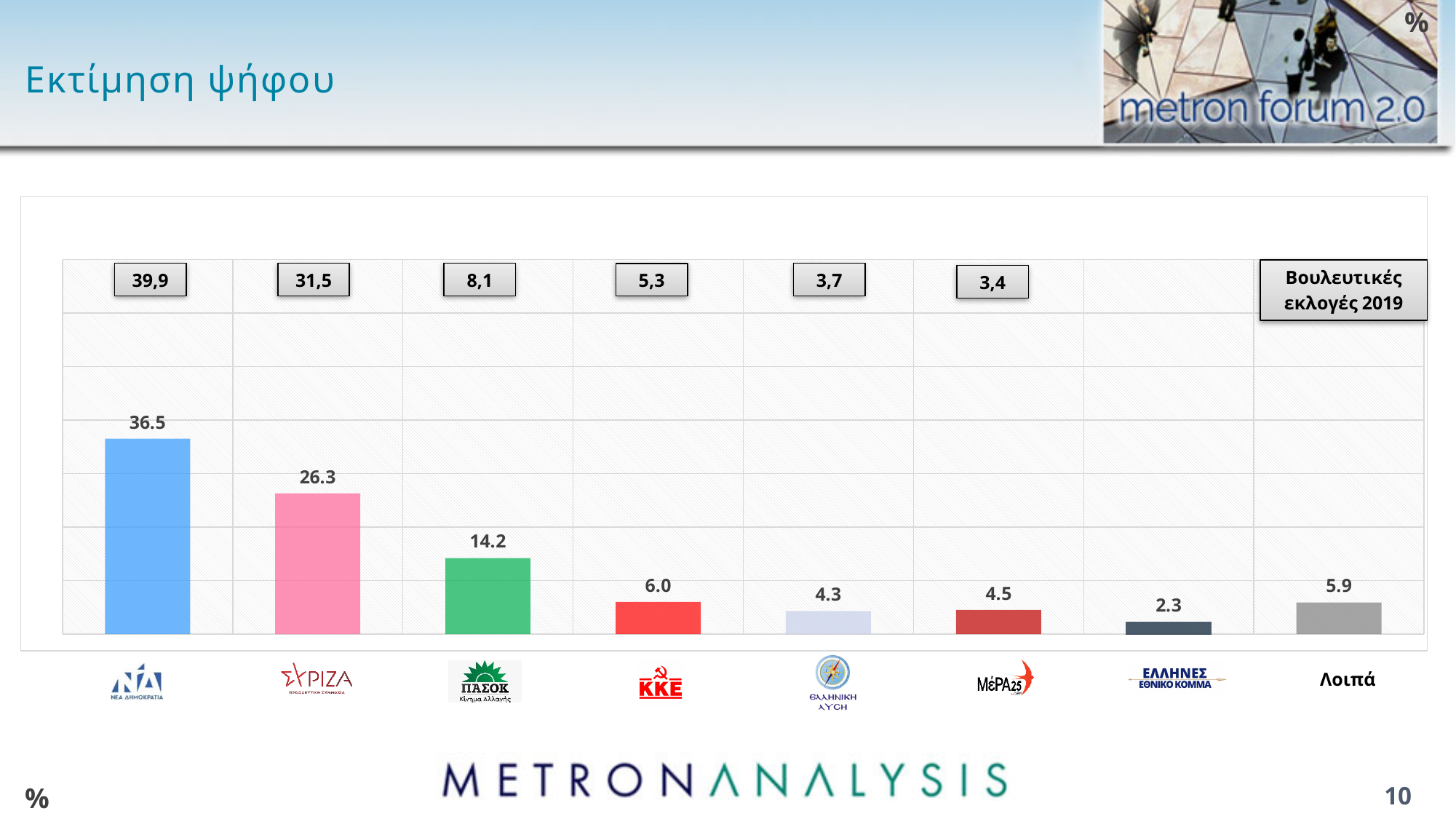
What is the title of the slide? Εκτίμηση ψήφου Which is larger, the bar for ΚΚΕ or the bar for ΜέΡΑ25? ΚΚΕ How many bars are plotted in the chart? 8 What value is shown in the box above the ΠΑΣΟΚ bar for the Βουλευτικές εκλογές 2019? 8,1 Which category has the lowest bar? ΕΛΛΗΝΕΣ ΕΘΝΙΚΟ ΚΟΜΜΑ What is the difference between the bars for ΝΕΑ ΔΗΜΟΚΡΑΤΙΑ and ΣΥΡΙΖΑ? 10.2 What is the value of the bar for ΠΑΣΟΚ? 14.2 Which category has the highest bar? ΝΕΑ ΔΗΜΟΚΡΑΤΙΑ What is the value of the bar for ΝΕΑ ΔΗΜΟΚΡΑΤΙΑ? 36.5 What is the value of the bar for ΣΥΡΙΖΑ? 26.3 What kind of chart is shown on the slide? Bar chart What is the value of the bar for Λοιπά? 5.9